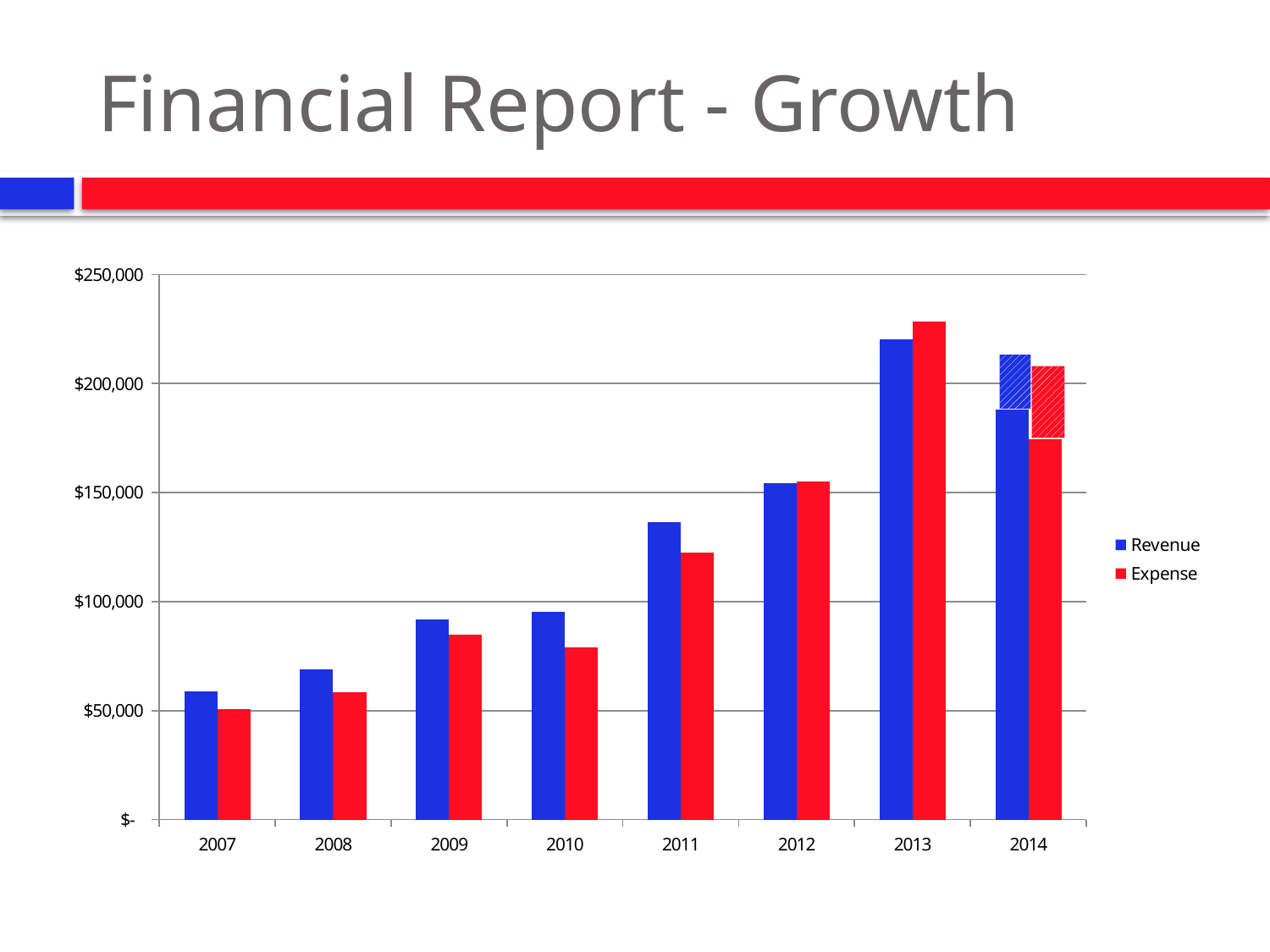
How many series does the chart's legend list? 2 Which year has the lowest Revenue value? 2007 What kind of chart is shown on the slide? bar chart Which year has the highest Expense value? 2013 Which year has the lowest Expense value? 2007 In 2011, which is larger, Revenue or Expense? Revenue Is the Revenue value for 2011 greater or less than $150,000? less How many years are shown on the x axis of the chart? 8 In 2013, which is larger, Revenue or Expense? Expense Which series are listed in the chart's legend? Revenue and Expense Is the Revenue value for 2013 greater or less than $200,000? greater Is the Expense value for 2010 greater or less than $100,000? less